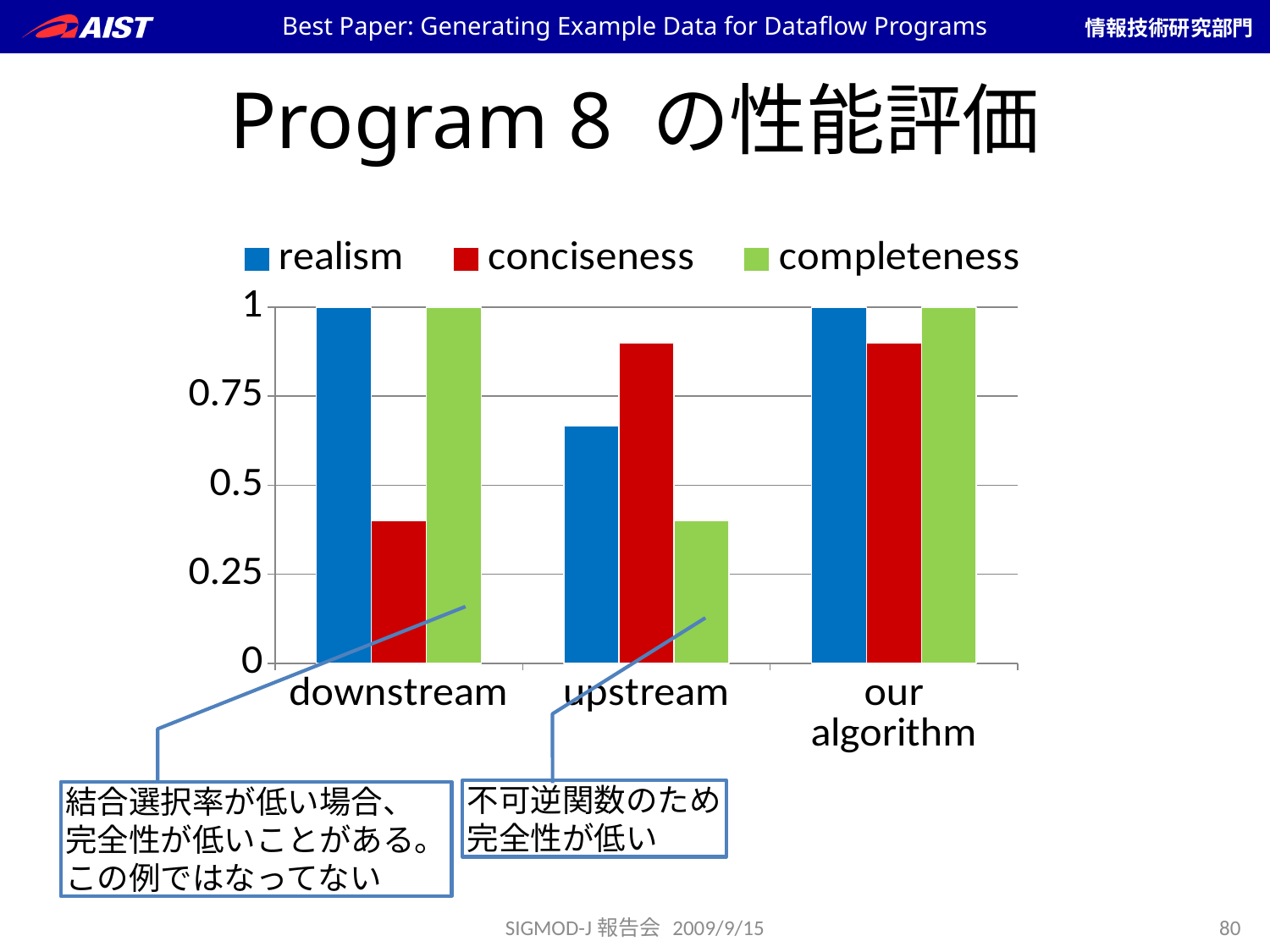
Is the conciseness value for downstream greater or less than 0.5? less For upstream, which series has the highest value? conciseness For downstream, which series has the lowest value? conciseness What is the realism value for downstream? 1 Is the completeness value for upstream greater or less than 0.5? less Is the realism value for upstream greater or less than 0.5? greater For upstream, which is larger: conciseness or completeness? conciseness How many series does the legend list? 3 What type of chart is shown on the slide? bar chart What is the completeness value for our algorithm? 1 How many categories are shown on the x axis? 3